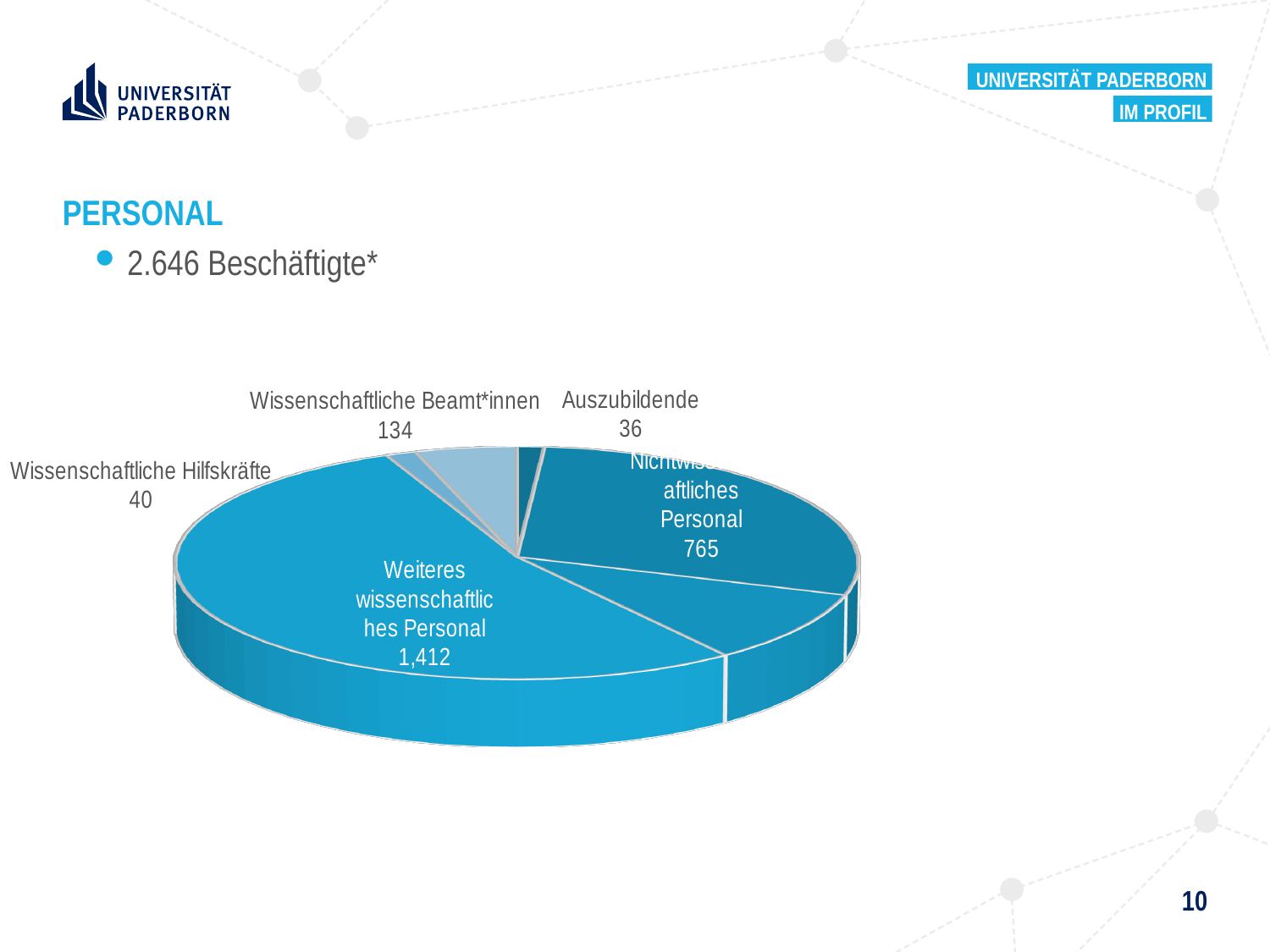
What is the difference between Wissenschaftliche Beamt*innen and Wissenschaftliche Hilfskräfte? 94 What is the value for Auszubildende? 36 What is the total number of Beschäftigte stated on the slide? 2.646 Which is larger, Wissenschaftliche Hilfskräfte or Auszubildende? Wissenschaftliche Hilfskräfte What type of chart is shown on the slide? Pie chart What is the value for Weiteres wissenschaftliches Personal? 1,412 Which labelled category has the smallest value? Auszubildende Which labelled category has the largest slice of the pie? Weiteres wissenschaftliches Personal What is the value for Wissenschaftliche Beamt*innen? 134 What is the difference between Weiteres wissenschaftliches Personal and Nichtwissenschaftliches Personal? 647 What is the value for Wissenschaftliche Hilfskräfte? 40 What is the value for Nichtwissenschaftliches Personal? 765